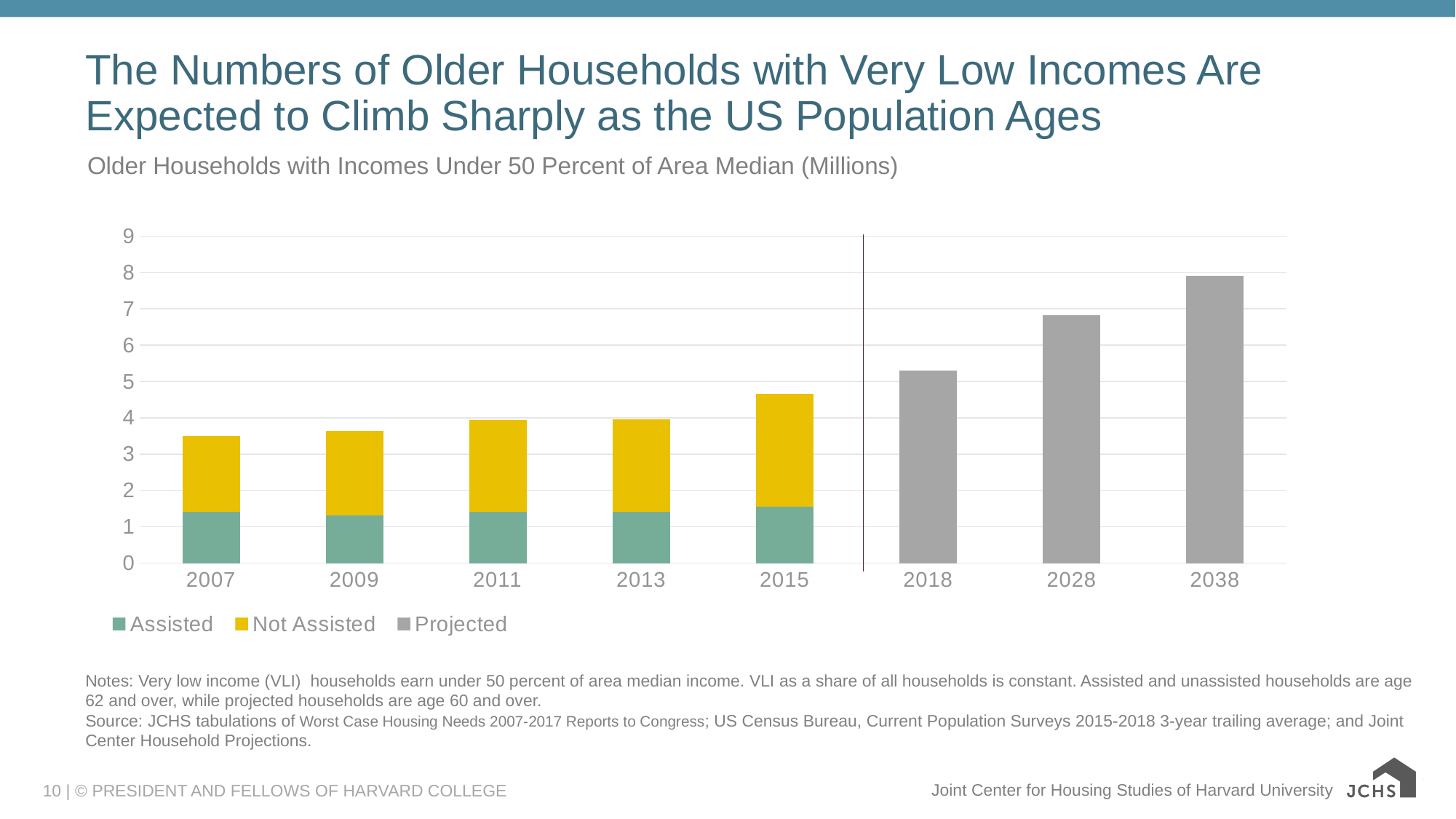
How many years are shown along the x axis? 8 Is the total for 2015 greater or less than 4? greater Which is larger, the value for 2018 or the value for 2038? 2038 Is the value for 2038 greater or less than 7? greater Is the value for 2018 greater or less than 5? greater How many series does the legend list? 3 Which year has the highest bar? 2038 What kind of chart is shown on the slide? bar chart Which legend entry is shown in gray? Projected Do the values generally rise or fall from 2007 to 2038? rise